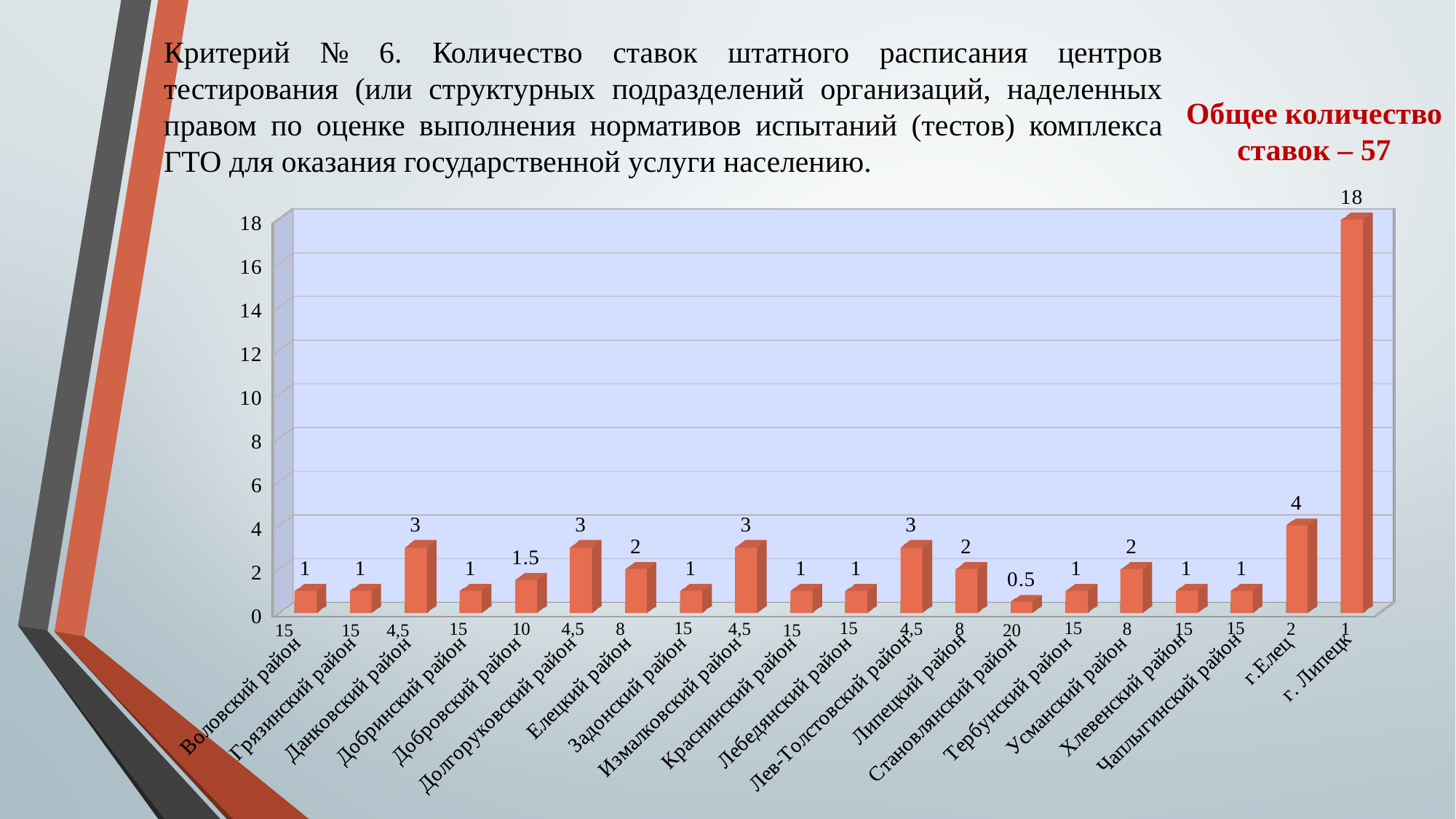
What is the difference between the values for г. Липецк and г.Елец? 14 What is the value for Становлянский район? 0.5 What is the value for г.Елец? 4 What is the value for г. Липецк? 18 Which category has the lowest value on the chart? Становлянский район What total number of staff positions (ставок) is stated in the red text on the slide? 57 What is the value for Добровский район? 1.5 Which is larger, the value for Данковский район or the value for Елецкий район? Данковский район Which category has the highest value on the chart? г. Липецк What type of chart is shown on the slide? bar chart How many categories (districts/cities) are plotted on the chart? 20 Is the value for г. Липецк greater or less than 16? greater